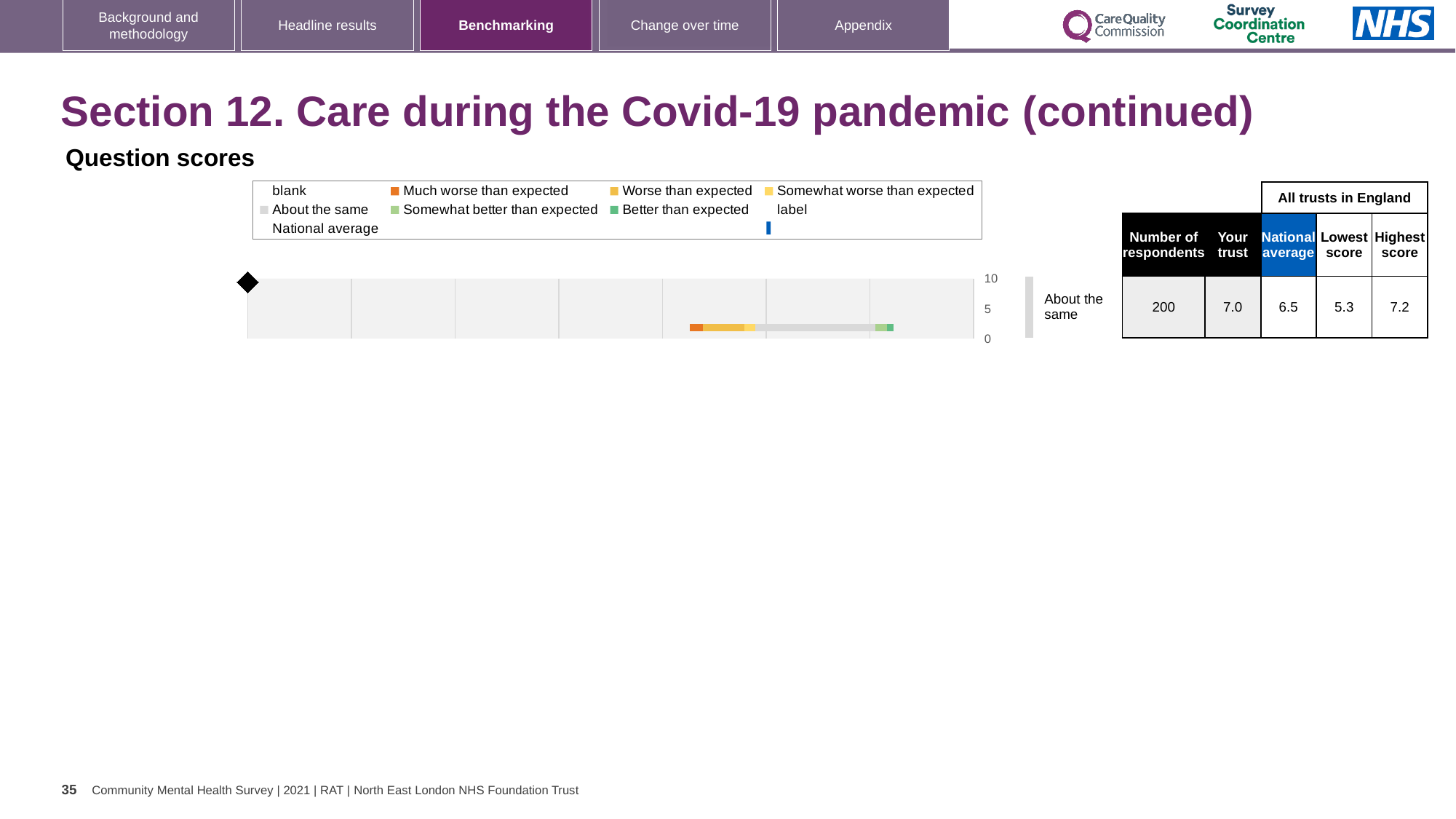
In the table beside the chart, what is the number of respondents? 200 In the table beside the chart, what is the lowest score among all trusts in England? 5.3 How many bars (categories) are plotted in the chart? 1 What is the difference between the highest score and the lowest score in the table? 1.9 Which is larger, the "Your trust" score or the national average? Your trust In the table beside the chart, what is the highest score among all trusts in England? 7.2 In the table beside the chart, what is the score for "Your trust"? 7.0 What kind of chart is shown under "Question scores"? bar chart In the table beside the chart, what is the national average score? 6.5 What is the highest value shown on the chart's numeric axis? 10 What category label is shown next to the bar in the chart? About the same What colour does the legend use for "Much worse than expected"? orange